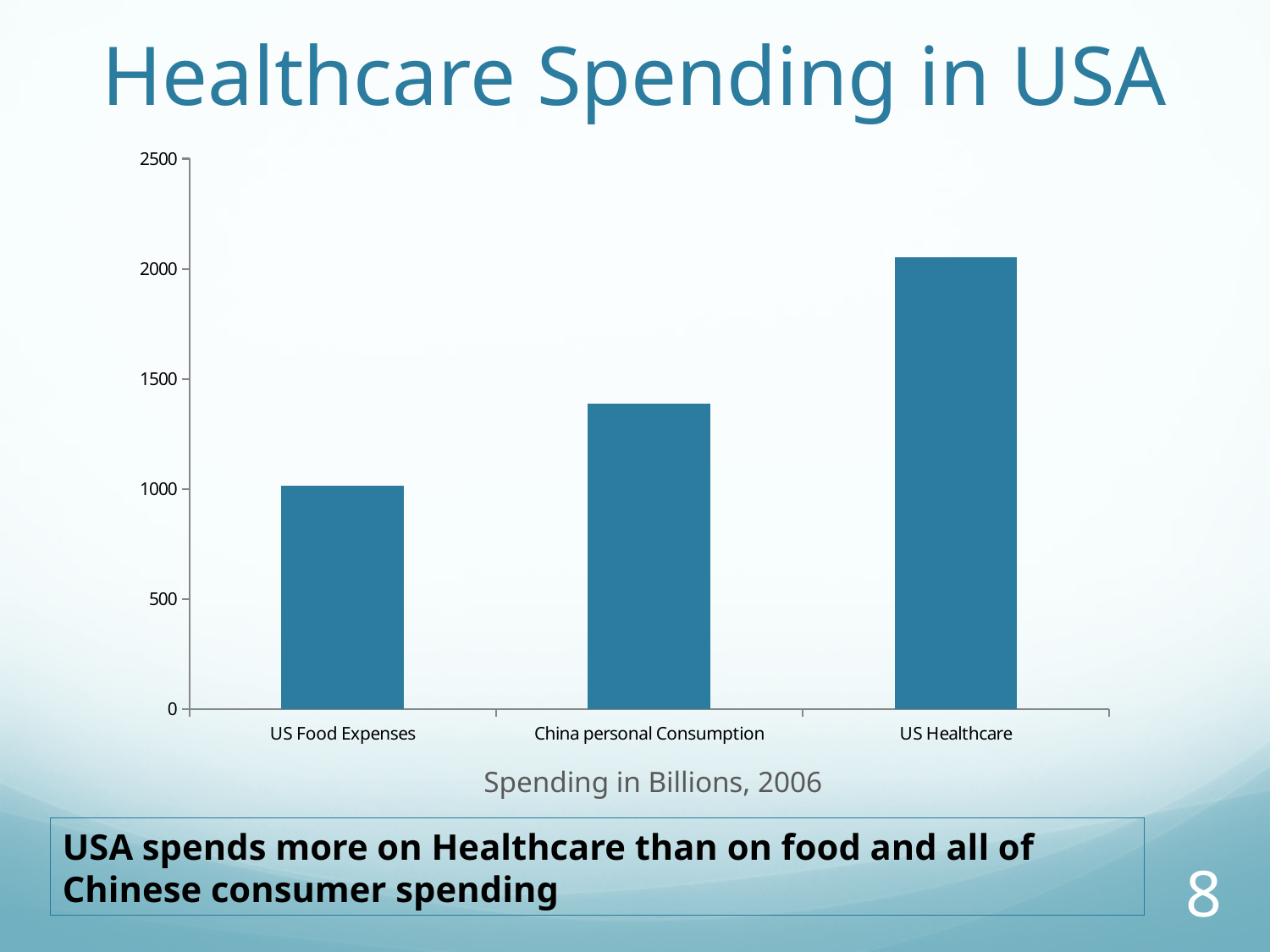
What is the caption shown below the chart's x axis? Spending in Billions, 2006 Is the value for China personal Consumption greater or less than 1500? less Which is larger, the value for US Healthcare or the value for China personal Consumption? US Healthcare Which category has the highest value in the chart? US Healthcare Is the value for US Healthcare greater or less than 2000? greater How many categories are shown in the chart? 3 Do the values rise or fall from left to right across the categories? Rise Is the value for China personal Consumption greater or less than 1000? greater Which category has the lowest value in the chart? US Food Expenses What kind of chart is shown on the slide? Bar chart Which is larger, the value for China personal Consumption or the value for US Food Expenses? China personal Consumption